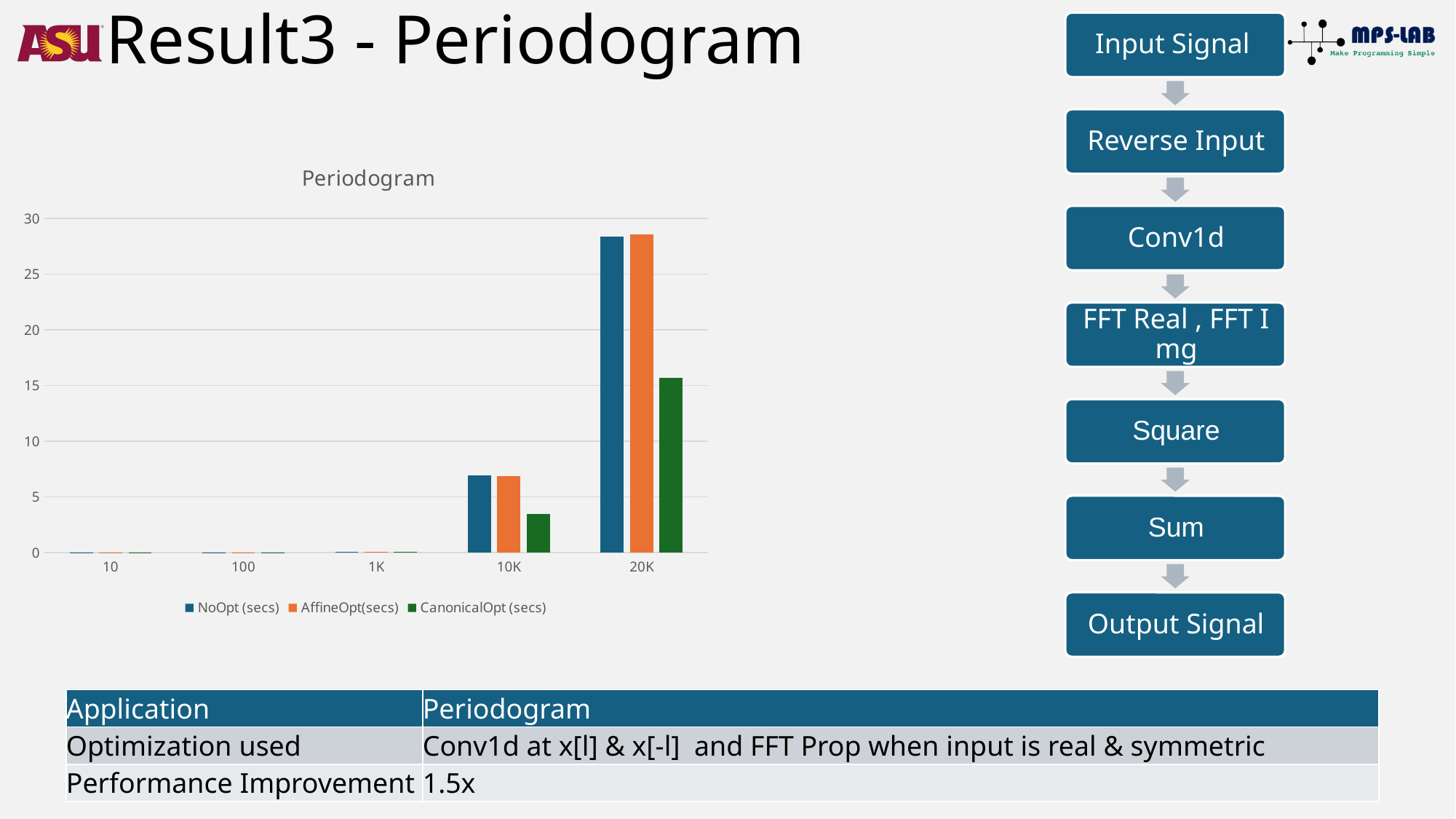
At 20K, which series has the lowest value? CanonicalOpt (secs) Is the CanonicalOpt (secs) value for 20K greater or less than 20? less Which colour represents the CanonicalOpt (secs) series in the chart? green What is the title of the chart? Periodogram Is the CanonicalOpt (secs) value for 10K greater or less than 5? less Do the NoOpt (secs) values rise or fall as the input size increases from 10 to 20K? rise How many categories are shown on the x axis of the chart? 5 What kind of chart is shown on the slide? bar chart Which category has the highest NoOpt (secs) value? 20K How many series does the chart legend list? 3 Is the NoOpt (secs) value for 20K greater or less than 25? greater At 20K, which is larger: NoOpt (secs) or CanonicalOpt (secs)? NoOpt (secs)